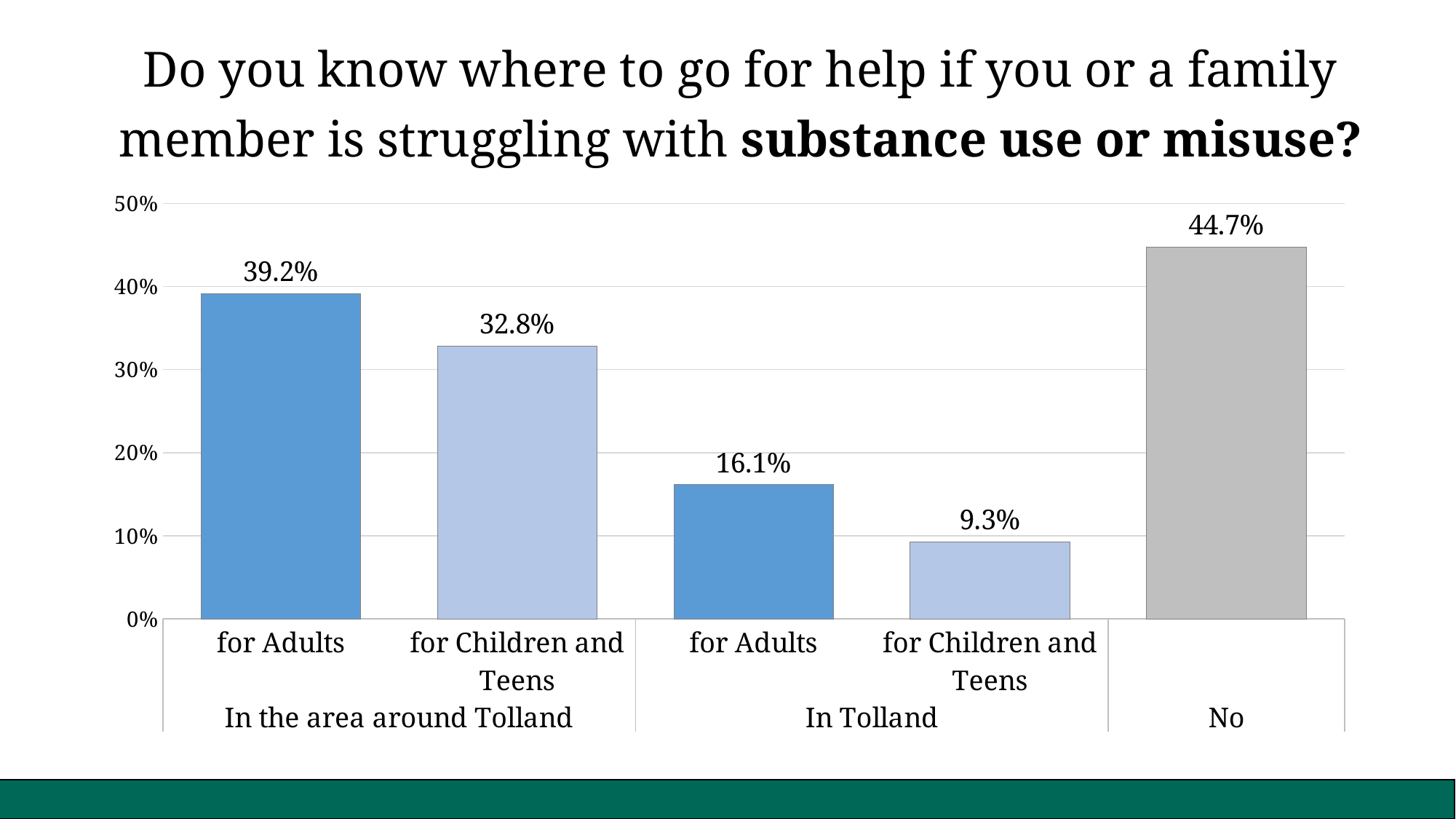
What kind of chart is shown on the slide? Bar chart Which bar has the lowest value? for Children and Teens (In Tolland) How many bars are plotted on the chart? 5 What is the difference between the 'No' bar and 'for Adults' in the 'In the area around Tolland' group? 5.5% What is the value for 'for Adults' in the 'In the area around Tolland' group? 39.2% What is the value for 'for Adults' in the 'In Tolland' group? 16.1% Which bar has the highest value? No What is the value for 'for Children and Teens' in the 'In Tolland' group? 9.3% What is the highest value shown on the vertical axis? 50% What is the value for the 'No' bar? 44.7% What is the difference between 'for Adults' and 'for Children and Teens' in the 'In the area around Tolland' group? 6.4% Which is larger: 'for Children and Teens' in the 'In the area around Tolland' group or 'for Adults' in the 'In Tolland' group? for Children and Teens (In the area around Tolland)